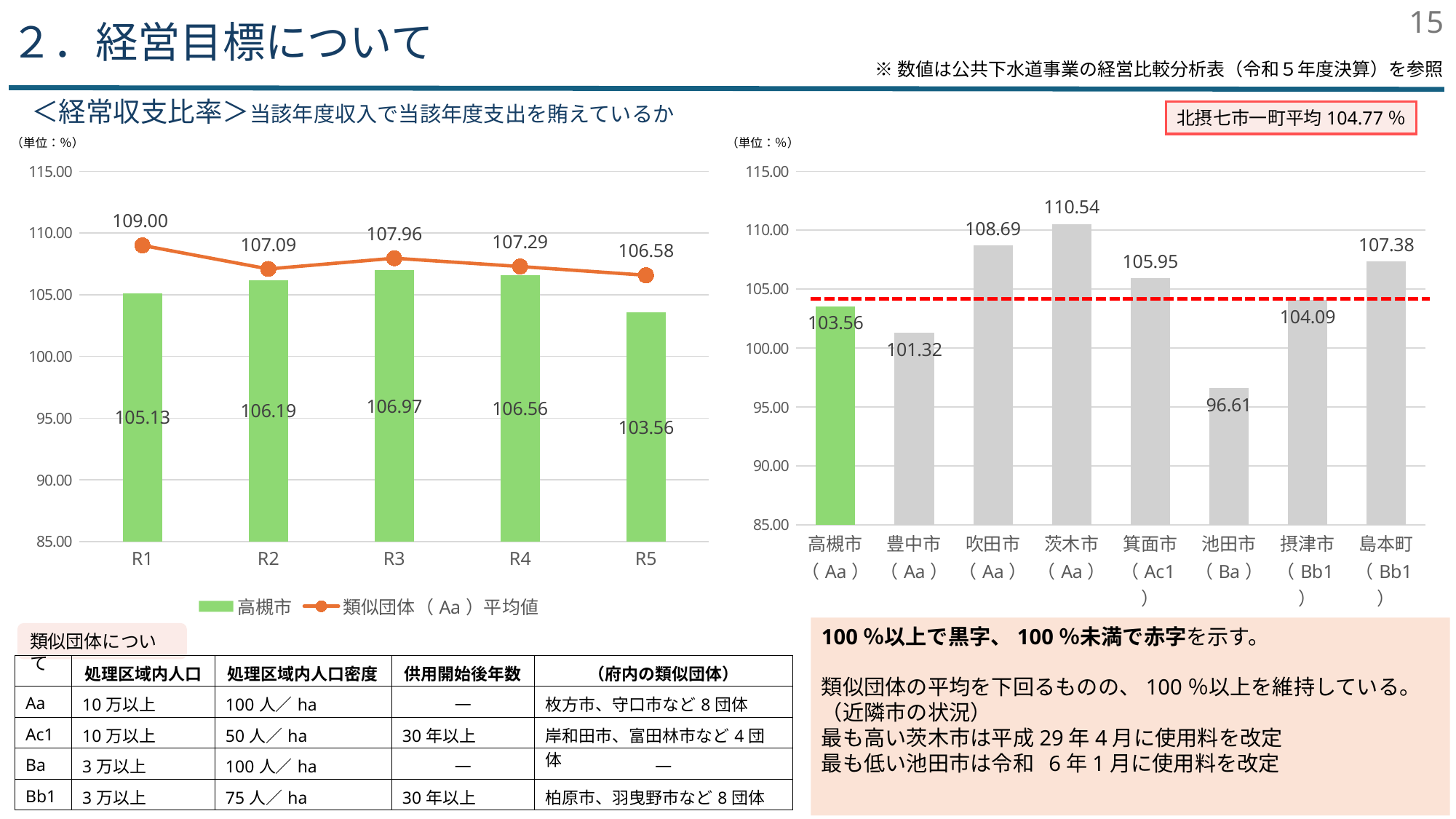
In the left chart, in which year is the 高槻市 value lowest? R5 In the right chart, which municipality has the highest value? 茨木市 How many series does the legend of the left chart list? 2 In the left chart, what is the value for 高槻市 in R3? 106.97 In the left chart, what is the 類似団体（Aa）平均値 value in R1? 109.00 In the right chart, which has the larger value, 吹田市 or 島本町? 吹田市 In the right chart, what is the value for 摂津市? 104.09 In the right chart, which municipality has the lowest value? 池田市 How many municipalities are shown in the right chart? 8 In the left chart, what is the difference between the 類似団体（Aa）平均値 and the 高槻市 value in R5? 3.02 What kind of chart is the left chart? A bar chart combined with a line chart In the right chart, what is the difference between the values for 茨木市 and 池田市? 13.93